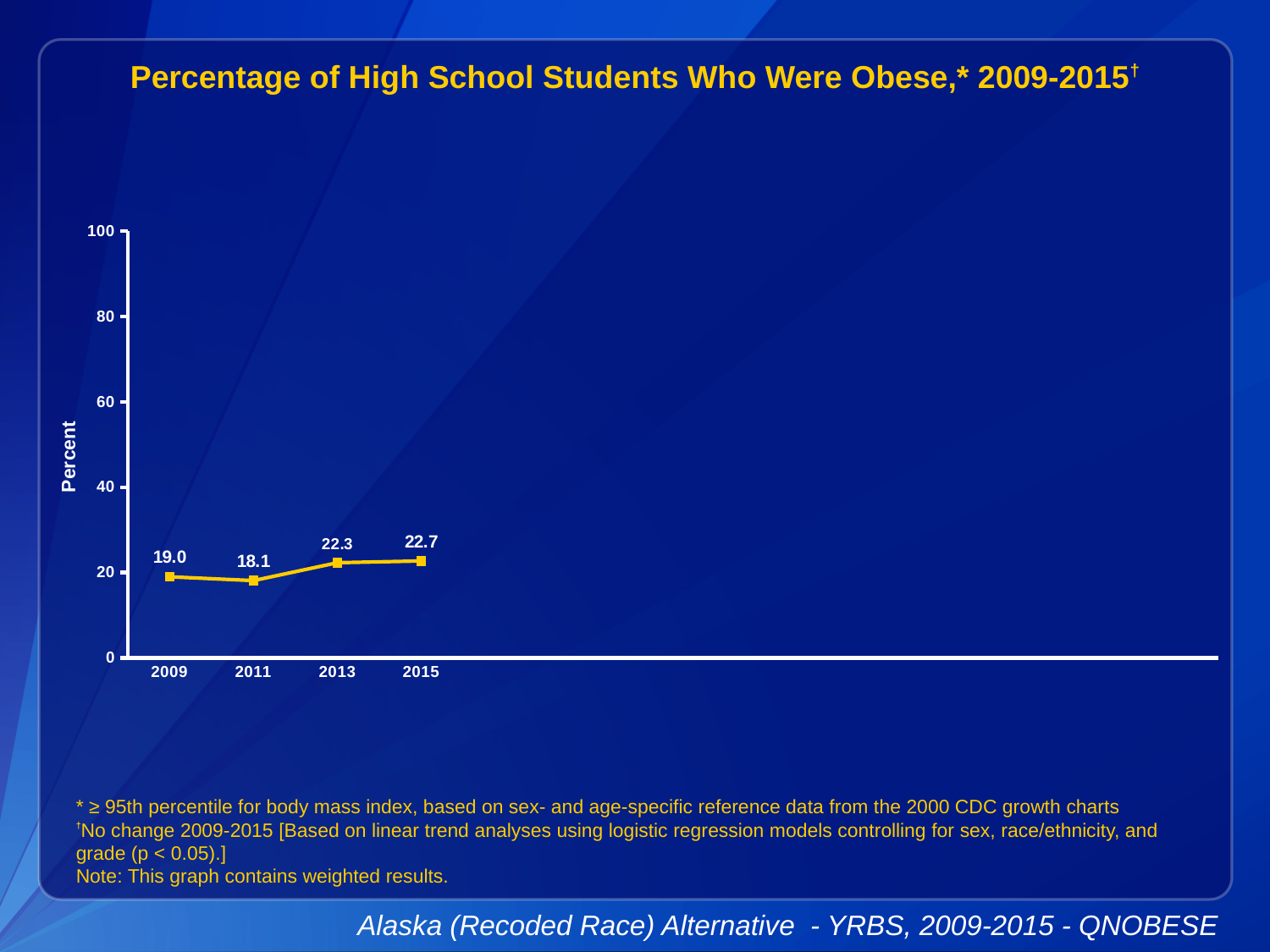
What is the percentage of high school students who were obese in 2013? 22.3 Which year has the highest percentage of obese high school students? 2015 What is the label on the y axis of the chart? Percent What is the percentage of high school students who were obese in 2015? 22.7 What is the difference between the 2015 and 2009 values? 3.7 Is the value for 2015 greater or less than 40? less How many years are plotted on the chart? 4 Which year has a larger value, 2011 or 2013? 2013 Which year has the lowest percentage of obese high school students? 2011 What is the percentage of high school students who were obese in 2011? 18.1 What kind of chart is shown on the slide? line chart What is the percentage of high school students who were obese in 2009? 19.0